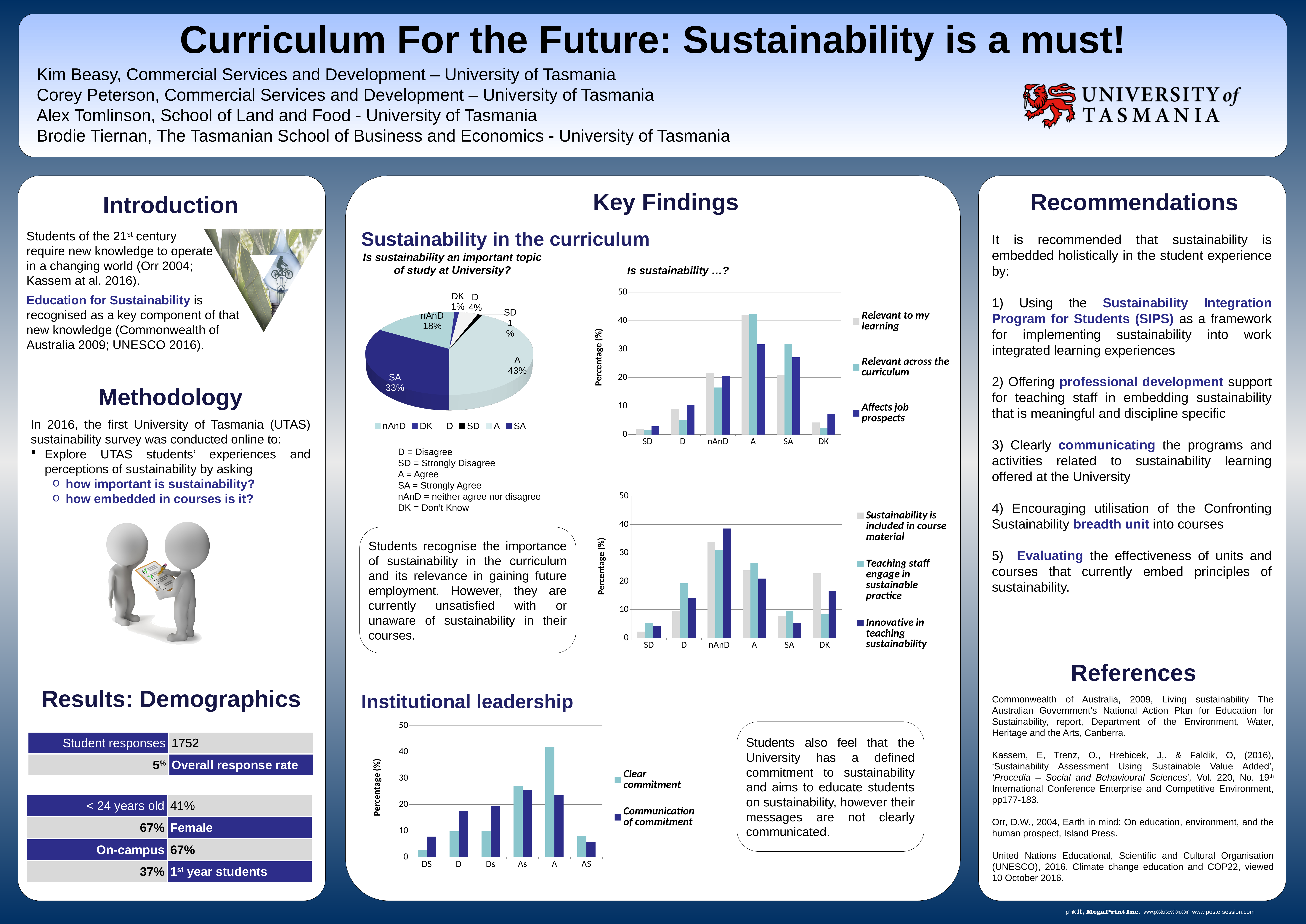
In the 'Institutional leadership' bar chart, is the value for A in the 'Clear commitment' series greater or less than 40? greater What type of chart is used for 'Is sustainability an important topic of study at University?' Pie chart In the pie chart 'Is sustainability an important topic of study at University?', what percentage of respondents answered A (Agree)? 43% In the bar chart 'Is sustainability ...?', is the value for A in the 'Relevant to my learning' series greater or less than 40? greater How many series does the legend of the bar chart 'Is sustainability ...?' list? 3 How many categories are shown on the x axis of the 'Institutional leadership' bar chart? 6 In the pie chart 'Is sustainability an important topic of study at University?', what is the difference in percentage points between A and SA? 10% How many slices does the pie chart 'Is sustainability an important topic of study at University?' have? 6 In the bar chart 'Is sustainability ...?', is the value for SA in the 'Relevant across the curriculum' series greater or less than 30? greater In the pie chart 'Is sustainability an important topic of study at University?', which response has the largest share? A In the pie chart 'Is sustainability an important topic of study at University?', what percentage answered SA (Strongly Agree)? 33% In the bar chart below 'Is sustainability ...?' (legend starting 'Sustainability is included in course material'), which category has the highest value for the 'Innovative in teaching sustainability' series? nAnD